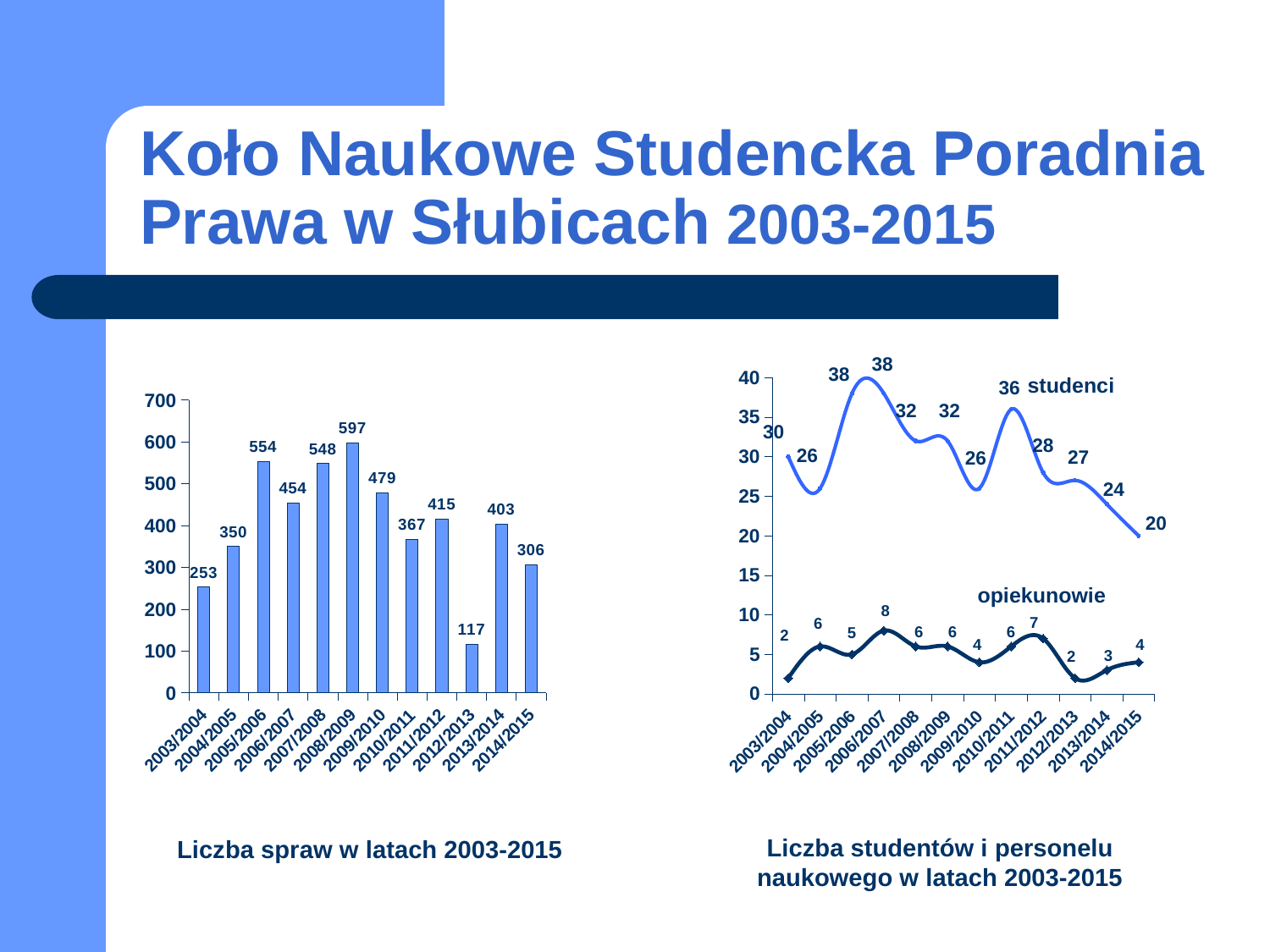
In the left chart (Liczba spraw w latach 2003-2015), how many years are shown on the x axis? 12 In the left chart (Liczba spraw w latach 2003-2015), what is the difference between the values for 2005/2006 and 2006/2007? 100 What kind of chart is the left chart (Liczba spraw w latach 2003-2015)? bar chart In the right chart (Liczba studentów i personelu naukowego), what is the opiekunowie value for 2006/2007? 8 In the left chart (Liczba spraw w latach 2003-2015), which year has the highest number of cases? 2008/2009 In the left chart (Liczba spraw w latach 2003-2015), is the value for 2013/2014 larger than the value for 2014/2015? Yes, 403 is larger than 306 How many series are plotted in the right chart (Liczba studentów i personelu naukowego)? 2 In the right chart (Liczba studentów i personelu naukowego), what is the lowest studenci value? 20 In the left chart (Liczba spraw w latach 2003-2015), which year has the lowest number of cases? 2012/2013 In the right chart (Liczba studentów i personelu naukowego), what is the studenci value for 2010/2011? 36 In the left chart (Liczba spraw w latach 2003-2015), what is the value for 2008/2009? 597 In the right chart (Liczba studentów i personelu naukowego), what is the difference between the studenci and opiekunowie values for 2014/2015? 16